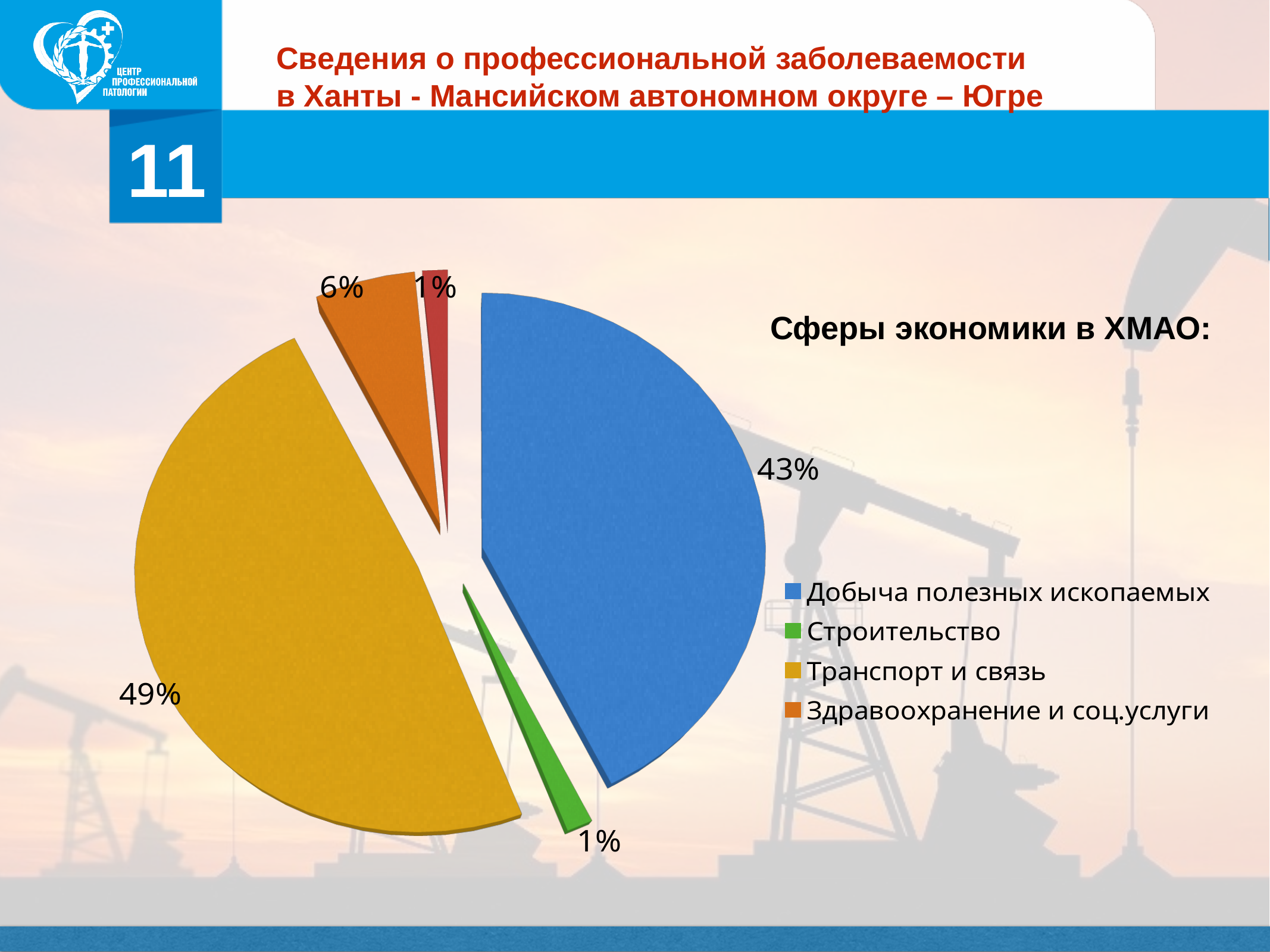
What share of the pie does Строительство have? 1% What share of the pie does Транспорт и связь have? 49% How many slices does the pie chart have? 5 What kind of chart is shown on the slide? Pie chart Which category has the largest share of the pie? Транспорт и связь What is the difference between the shares of Транспорт и связь and Добыча полезных ископаемых? 6% What colour is the slice for Транспорт и связь? Yellow What is the title of the chart? Сферы экономики в ХМАО: What share of the pie does Добыча полезных ископаемых have? 43% What share of the pie does Здравоохранение и соц.услуги have? 6% How many entries does the legend list? 4 Which is larger, the share of Добыча полезных ископаемых or the share of Здравоохранение и соц.услуги? Добыча полезных ископаемых